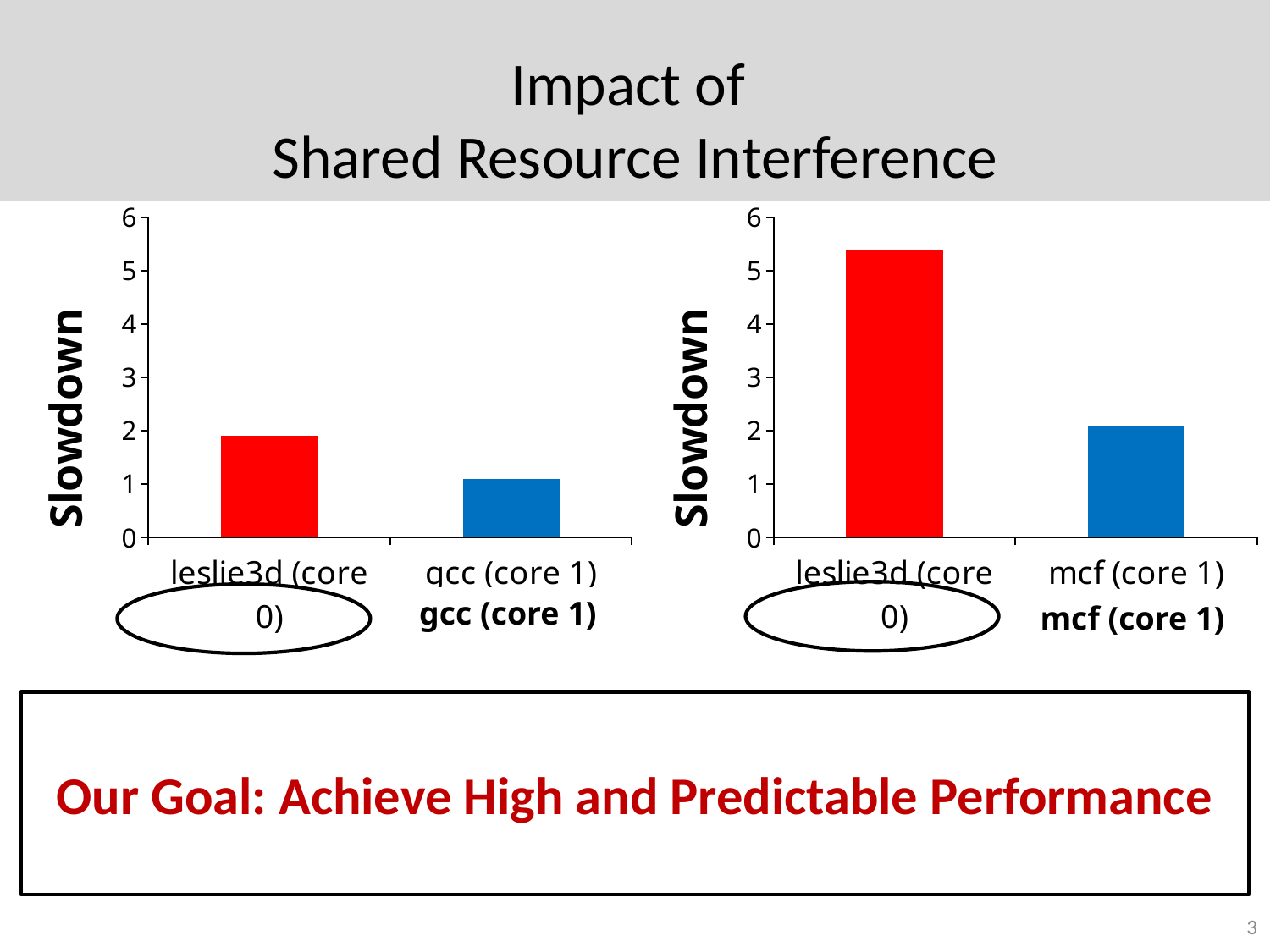
In the left chart, is the slowdown for gcc (core 1) greater or less than 2? less In the right chart, is the slowdown for mcf (core 1) greater or less than 3? less In the right chart, is the slowdown for leslie3d (core 0) greater or less than 5? greater In the left chart, which category has the lowest slowdown? gcc (core 1) In the right chart, which category has the highest slowdown? leslie3d (core 0) In the right chart, which category has the lowest slowdown? mcf (core 1) In the left chart, which category has the higher slowdown? leslie3d (core 0) What type of chart is the left chart on the slide? bar chart What is the y-axis label of the right chart? Slowdown In the right chart, how many categories are shown on the x axis? 2 In the left chart, how many bars are plotted? 2